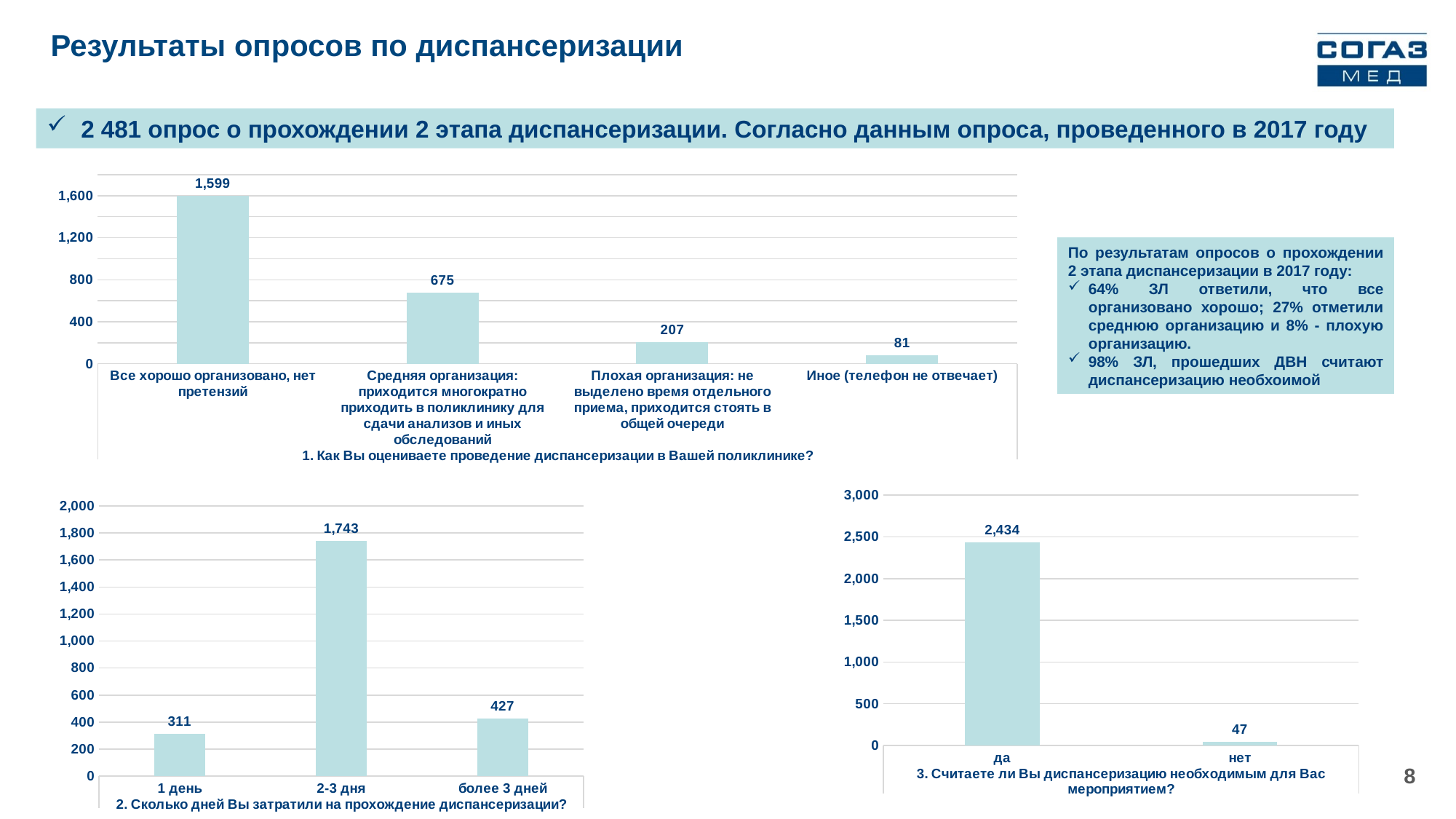
In the bottom-right chart (question 3), what is the value for 'нет'? 47 In the top chart (question 1), what is the difference between the values for 'Средняя организация' and 'Плохая организация'? 468 In the top chart (question 1, 'Как Вы оцениваете проведение диспансеризации в Вашей поликлинике?'), what is the value for 'Все хорошо организовано, нет претензий'? 1,599 What type of chart is the bottom-right chart (question 3)? Bar chart In the top chart (question 1), what is the value for 'Иное (телефон не отвечает)'? 81 In the bottom-right chart (question 3, 'Считаете ли Вы диспансеризацию необходимым для Вас мероприятием?'), what is the value for 'да'? 2,434 In the bottom-left chart (question 2), what is the difference between the values for 'более 3 дней' and '1 день'? 116 In the bottom-left chart (question 2, 'Сколько дней Вы затратили на прохождение диспансеризации?'), what is the value for '2-3 дня'? 1,743 How many categories are shown in the top chart (question 1)? 4 In the bottom-left chart (question 2), which category has the highest value? 2-3 дня In the top chart (question 1), which category has the lowest value? Иное (телефон не отвечает) In the bottom-left chart (question 2), which is larger: the value for '1 день' or for 'более 3 дней'? более 3 дней